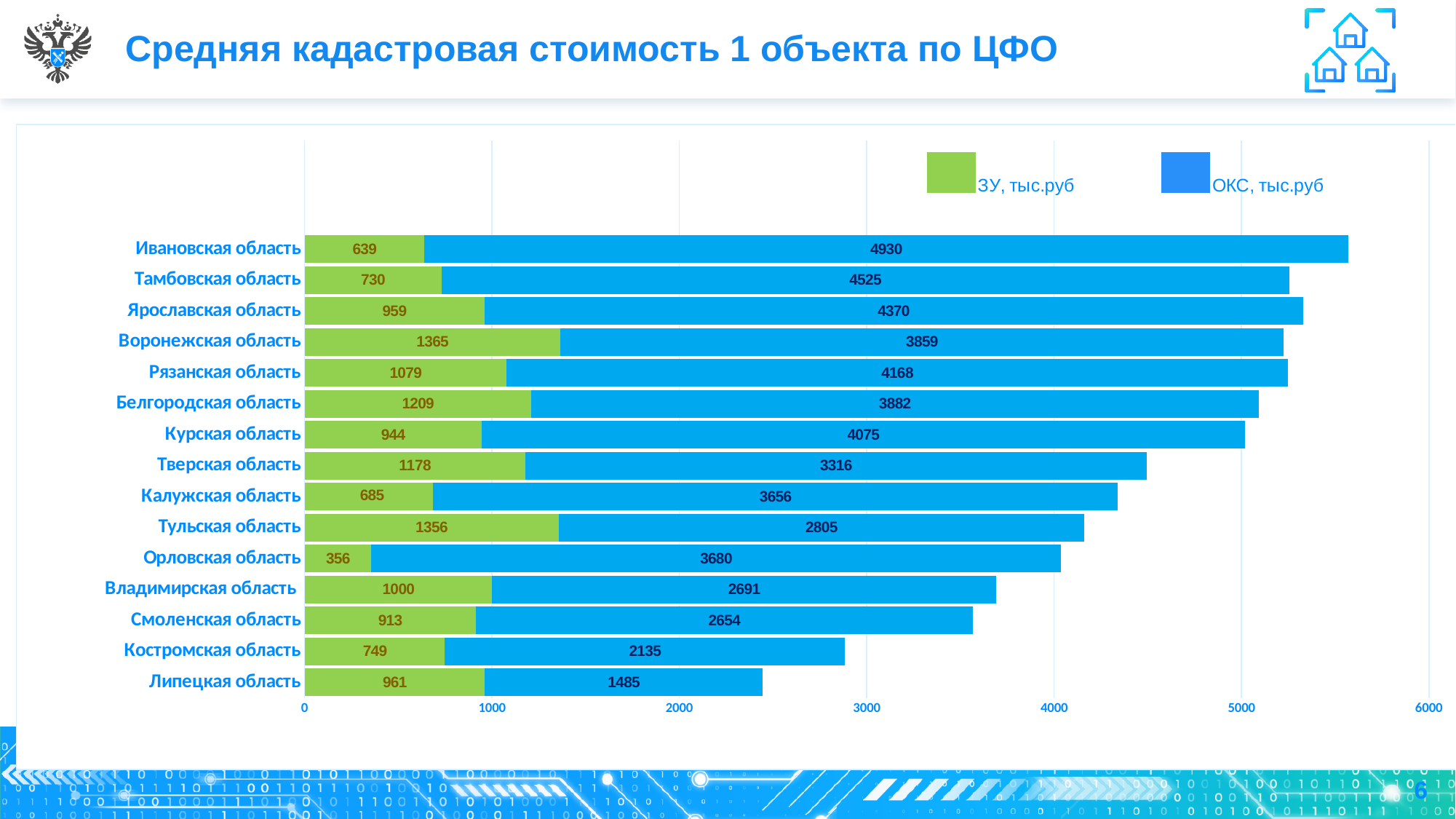
How many regions are shown in the chart? 15 What is the ОКС, тыс.руб value for Ивановская область? 4930 What is the ЗУ, тыс.руб value for Орловская область? 356 Is the total stacked bar for Ивановская область greater or less than 5000? greater What is the total of the stacked bar for Липецкая область? 2446 Which region has the lowest ЗУ, тыс.руб value? Орловская область What is the difference between the ОКС, тыс.руб values for Ивановская область and Тамбовская область? 405 What kind of chart is shown on the slide? Stacked bar chart How many series does the legend list? 2 Which is larger: the ЗУ, тыс.руб value for Воронежская область or for Калужская область? Воронежская область Which region has the lowest ОКС, тыс.руб value? Липецкая область Which region has the highest ОКС, тыс.руб value? Ивановская область